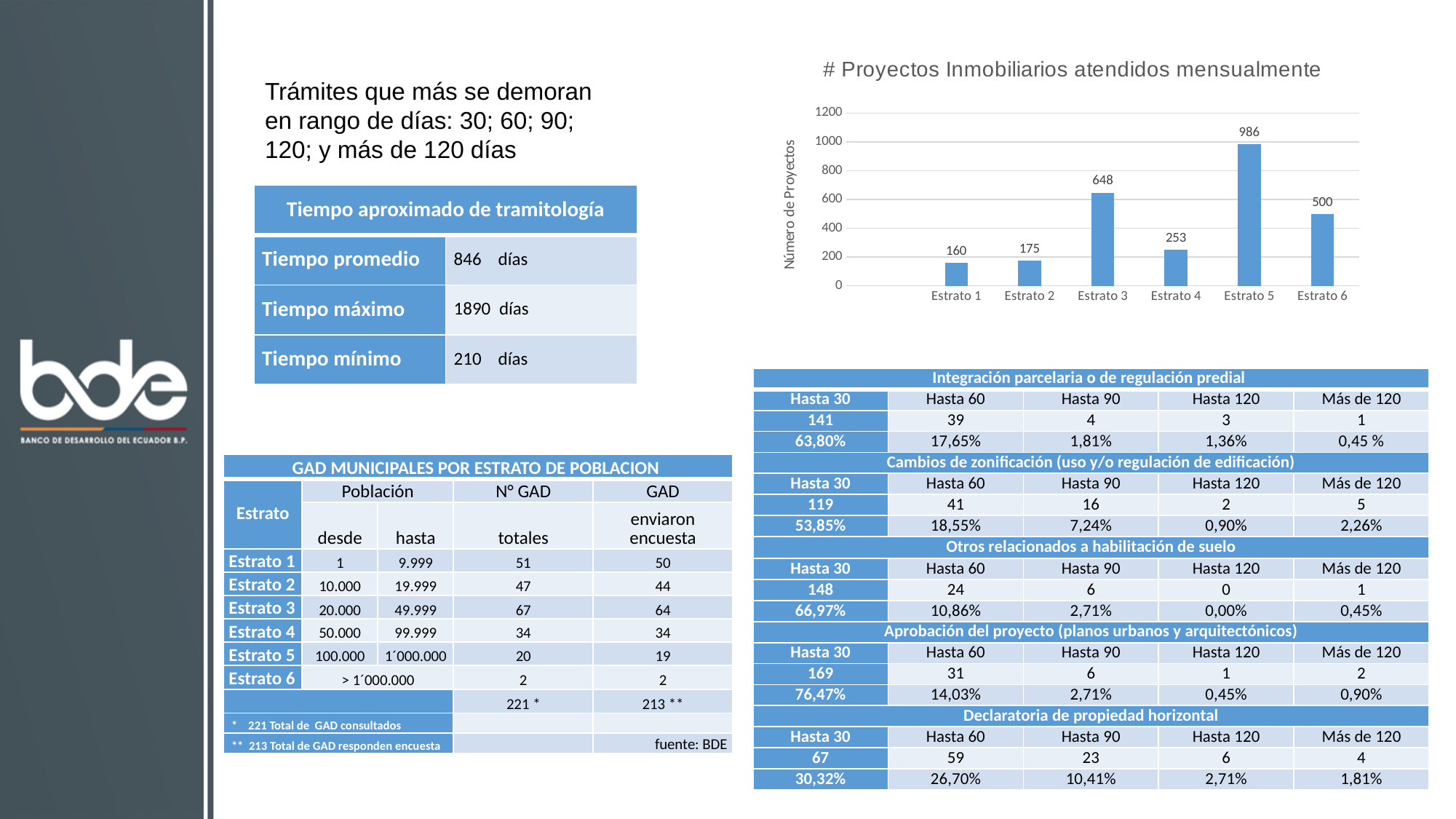
What is the value for Estrato 1 in the chart? 160 Which is larger in the chart, the value for Estrato 2 or the value for Estrato 4? Estrato 4 What is the difference between the values for Estrato 5 and Estrato 4 in the chart? 733 How many categories (estratos) are plotted in the chart? 6 What is the value for Estrato 3 in the chart? 648 What is the value for Estrato 6 in the chart? 500 What is the title of the chart on the slide? # Proyectos Inmobiliarios atendidos mensualmente Is the value for Estrato 5 in the chart greater or less than 800? greater Which estrato has the lowest number of projects in the chart? Estrato 1 What is the label of the vertical axis of the chart? Número de Proyectos Which estrato has the highest number of projects in the chart? Estrato 5 What type of chart is shown on the slide? bar chart